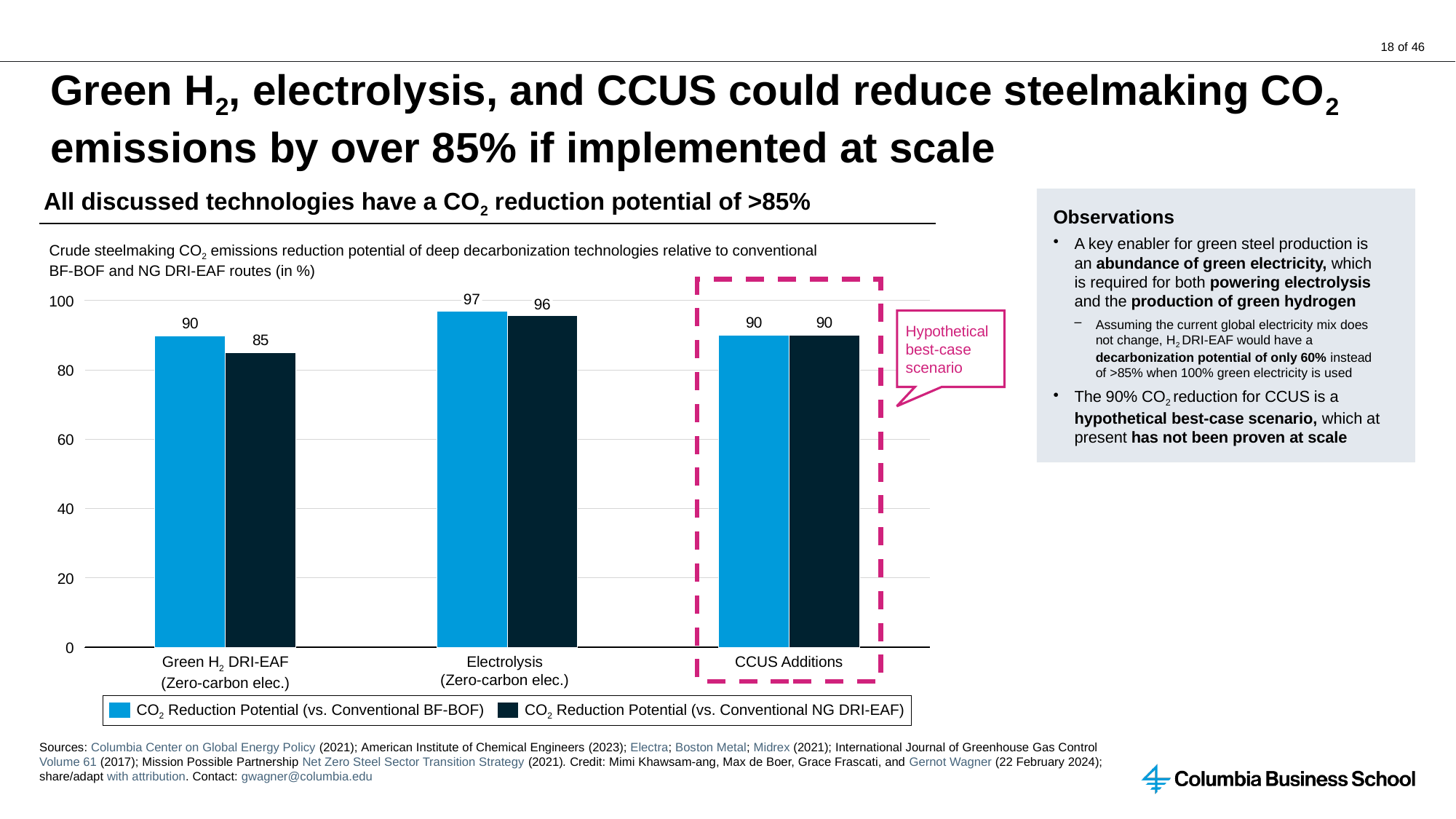
Which technology has the highest CO2 reduction potential vs. conventional BF-BOF? Electrolysis What is the CO2 reduction potential vs. conventional BF-BOF for Green H2 DRI-EAF? 90 Which technology has the lowest CO2 reduction potential vs. conventional NG DRI-EAF? Green H2 DRI-EAF What is the CO2 reduction potential vs. conventional NG DRI-EAF for CCUS Additions? 90 How many technology categories are shown on the x axis? 3 What kind of chart is shown on the slide? Bar chart How many series does the legend list? 2 What is the CO2 reduction potential vs. conventional BF-BOF for Electrolysis? 97 Which is larger: the Electrolysis value vs. conventional NG DRI-EAF or the CCUS Additions value vs. conventional NG DRI-EAF? Electrolysis What is the difference between the two values shown for Green H2 DRI-EAF? 5 What is the CO2 reduction potential vs. conventional NG DRI-EAF for Green H2 DRI-EAF? 85 What is the difference between the Electrolysis and Green H2 DRI-EAF values vs. conventional BF-BOF? 7